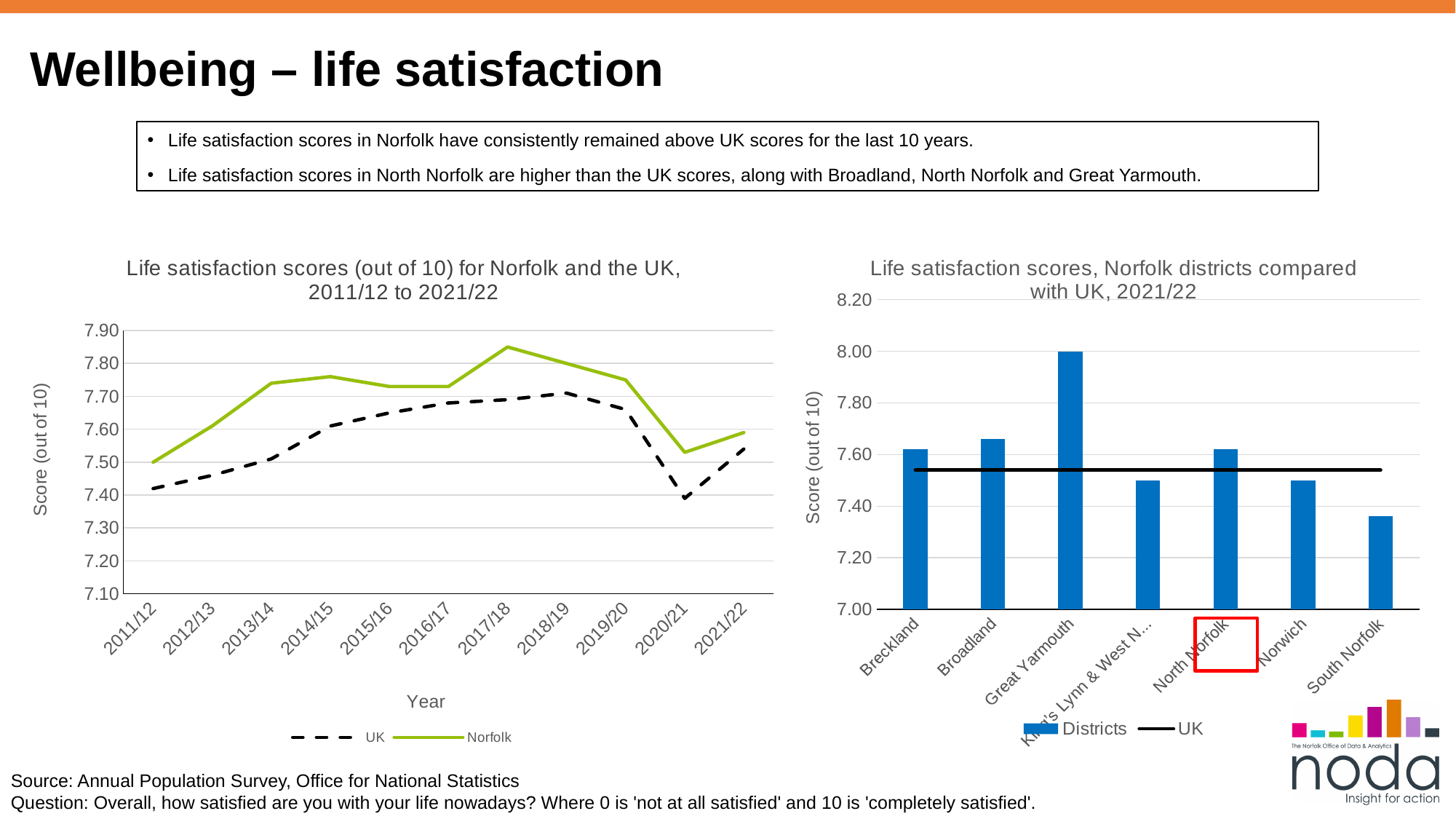
In the left chart, in which year does the Norfolk series reach its highest value? 2017/18 In the right chart, is the value for South Norfolk greater or less than 7.40? less In the left chart, in which year does the UK series reach its lowest value? 2020/21 In the left chart, is the Norfolk value for 2017/18 greater or less than 7.80? greater What kind of chart is the right chart, 'Life satisfaction scores, Norfolk districts compared with UK, 2021/22'? Bar chart In the left chart, how many years are shown on the x axis? 11 In the right chart, which district has the highest life satisfaction score? Great Yarmouth In the right chart, what is the life satisfaction score for Great Yarmouth? 8.00 What kind of chart is the left chart, 'Life satisfaction scores (out of 10) for Norfolk and the UK, 2011/12 to 2021/22'? Line chart In the left chart, how many series does the legend list? 2 In the right chart, which district has the lowest life satisfaction score? South Norfolk